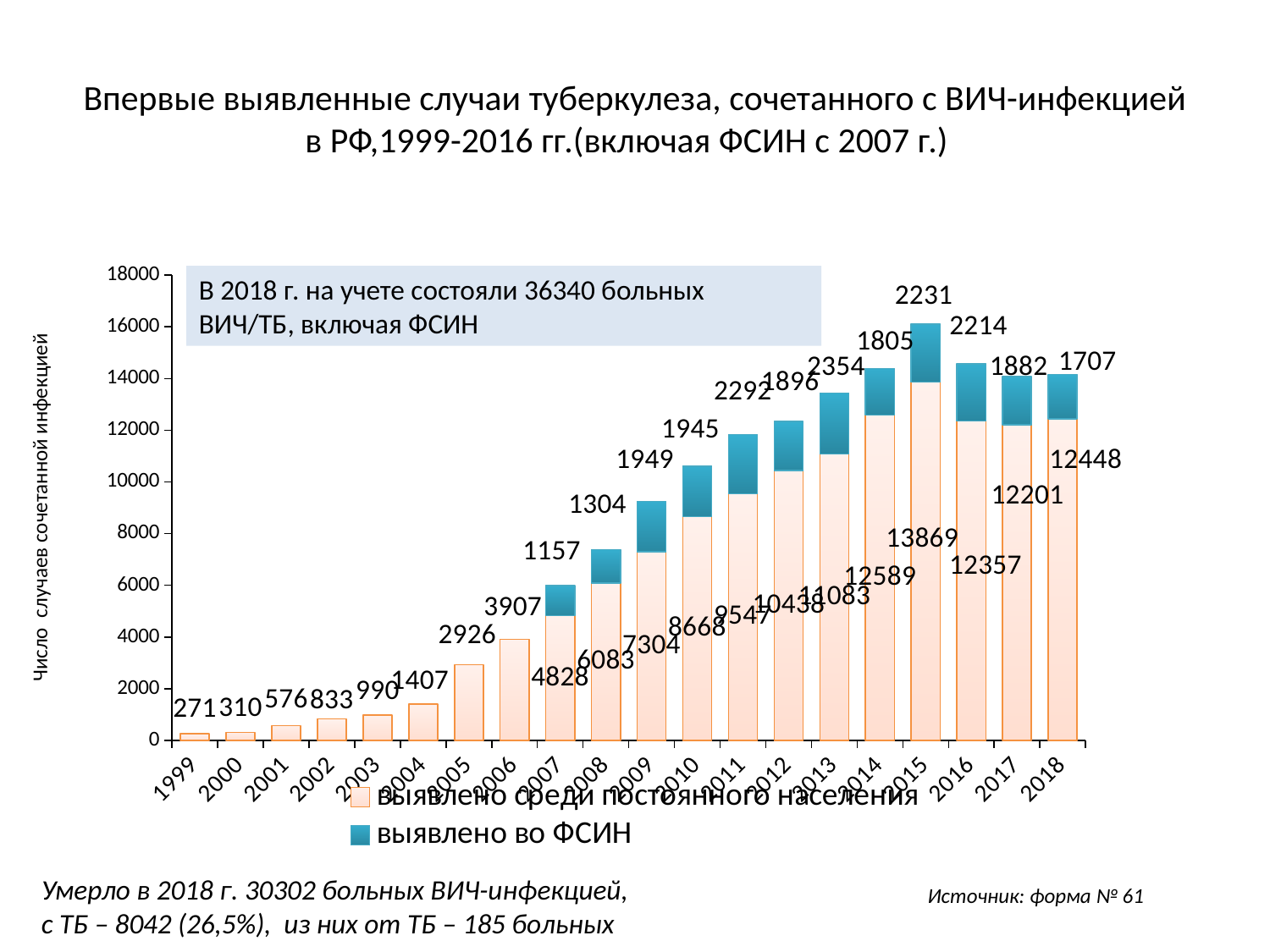
What is the value for 'выявлено среди постоянного населения' in 1999? 271 How many series does the legend list? 2 What is the total height of the stacked bar for 2018? 14155 Do the 'выявлено среди постоянного населения' values rise or fall from 1999 to 2015? rise What is the value for 'выявлено среди постоянного населения' in 2015? 13869 How many years are shown on the x axis? 20 Which is larger: the 'выявлено во ФСИН' value for 2013 or for 2014? 2013 What type of chart is shown on the slide? stacked bar chart What is the difference between the 'выявлено среди постоянного населения' values for 2018 and 2017? 247 In which year is the value for 'выявлено среди постоянного населения' lowest? 1999 In which year is the value for 'выявлено во ФСИН' highest? 2013 What is the value for 'выявлено во ФСИН' in 2007? 1157